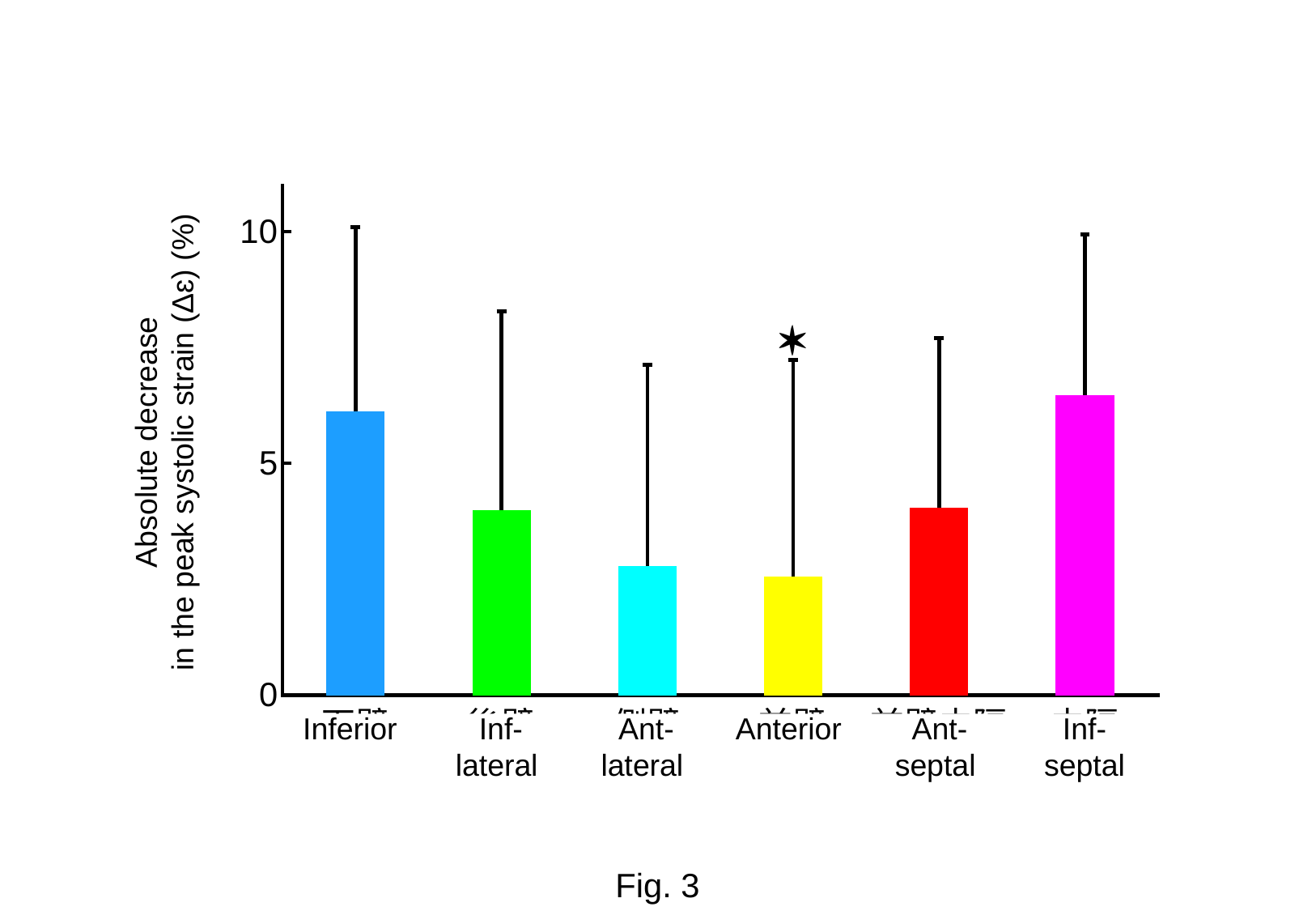
Is the value for Inf-septal greater or less than 5? greater Is the value for Inf-lateral greater or less than 5? less Is the value for Anterior greater or less than 5? less Which category's bar is marked with an asterisk? Anterior How many categories are plotted on the x axis? 6 Which has the larger value, Inferior or Inf-lateral? Inferior What kind of chart is shown on the slide? bar chart Which has the larger value, Ant-septal or Ant-lateral? Ant-septal What is the label of the y axis? Absolute decrease in the peak systolic strain (Δε) (%) Which has the larger value, Anterior or Inf-septal? Inf-septal